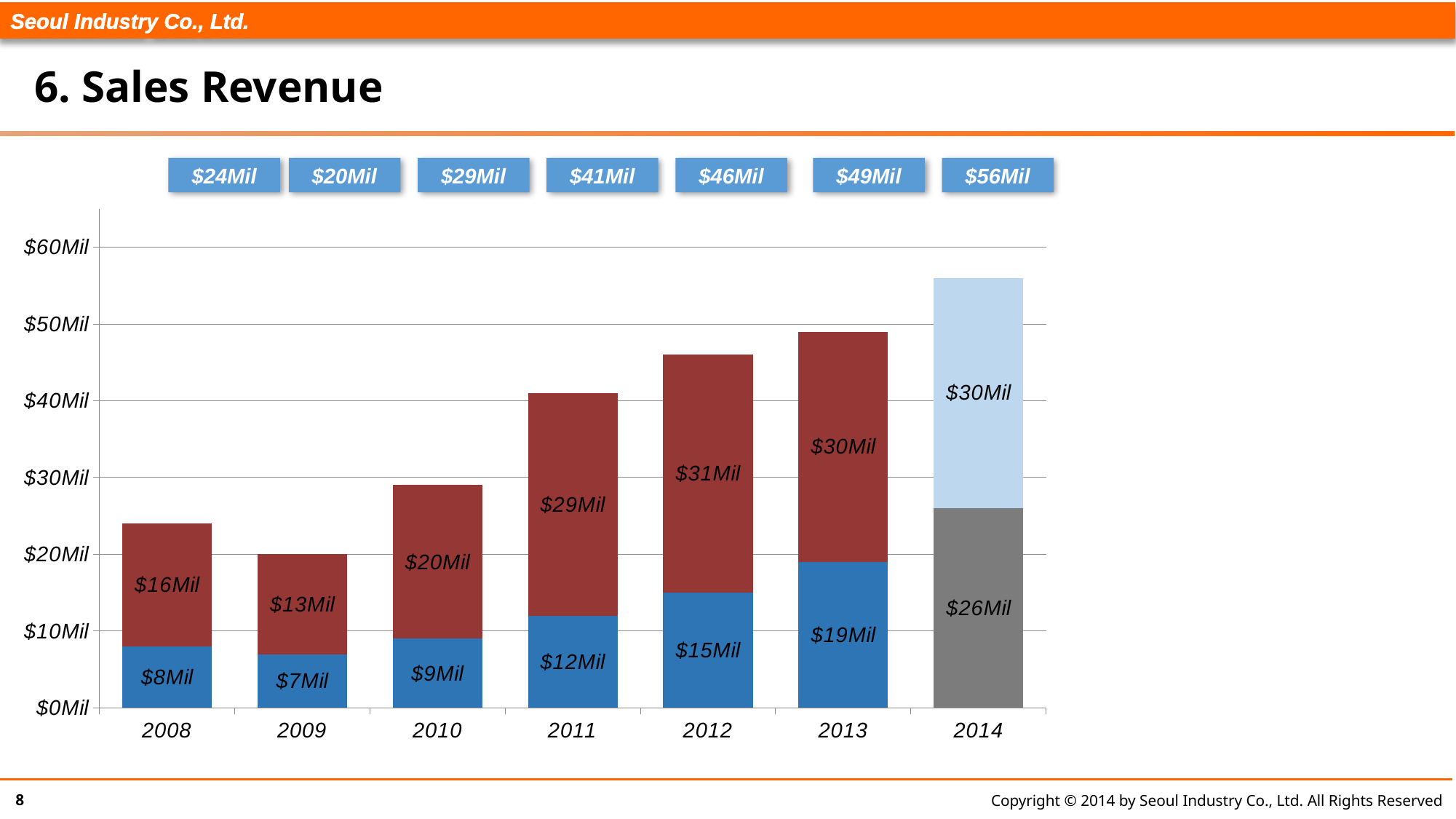
What is the value of the bottom (blue) segment of the 2008 bar? $8Mil What type of chart is shown on the slide? Stacked bar chart Which year has the lowest total sales revenue? 2009 Which is larger: the top segment of the 2012 bar or the top segment of the 2013 bar? 2012 ($31Mil) What is the value of the bottom (gray) segment of the 2014 bar? $26Mil What is the total sales revenue shown for 2012? $46Mil How many years are shown on the x axis of the chart? 7 What is the value of the top (red) segment of the 2011 bar? $29Mil Is the total revenue for 2011 greater or less than $40Mil? greater Do total sales revenues generally rise or fall from 2009 to 2014? Rise Which year has the highest total sales revenue? 2014 What is the difference between the total revenue for 2014 and the total revenue for 2013? $7Mil